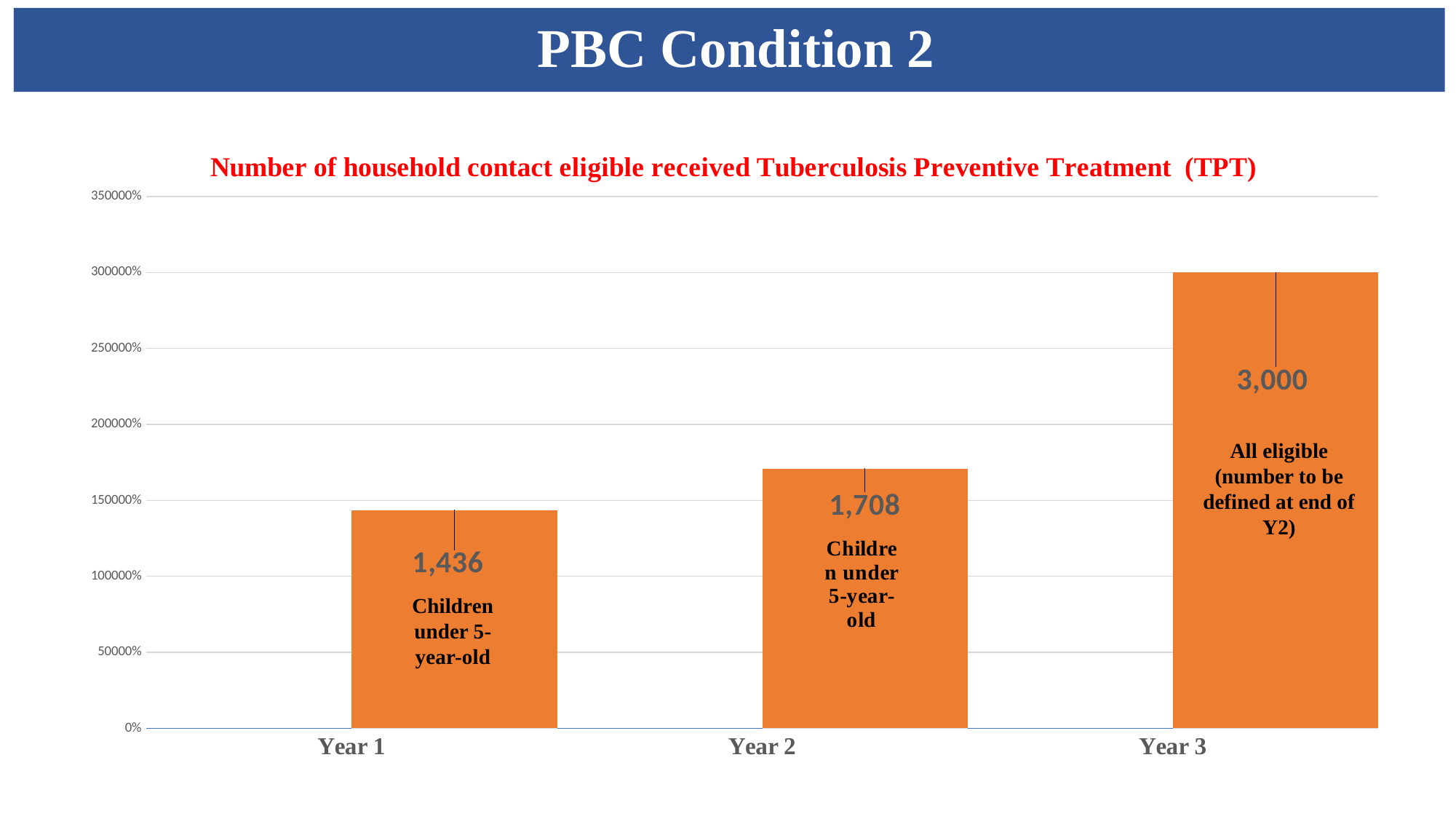
Do the values rise or fall from Year 1 to Year 3? Rise What is the value shown for Year 2? 1,708 Which year has the lowest value? Year 1 Which is larger, the value for Year 1 or the value for Year 2? Year 2 How many years (categories) are shown on the x axis? 3 What is the difference between the values for Year 2 and Year 1? 272 What is the value shown for Year 1? 1,436 Which year has the highest value? Year 3 What is the difference between the values for Year 3 and Year 2? 1,292 What is the value shown for Year 3? 3,000 What kind of chart is shown on the slide? Bar chart What is the title of the chart? Number of household contact eligible received Tuberculosis Preventive Treatment (TPT)